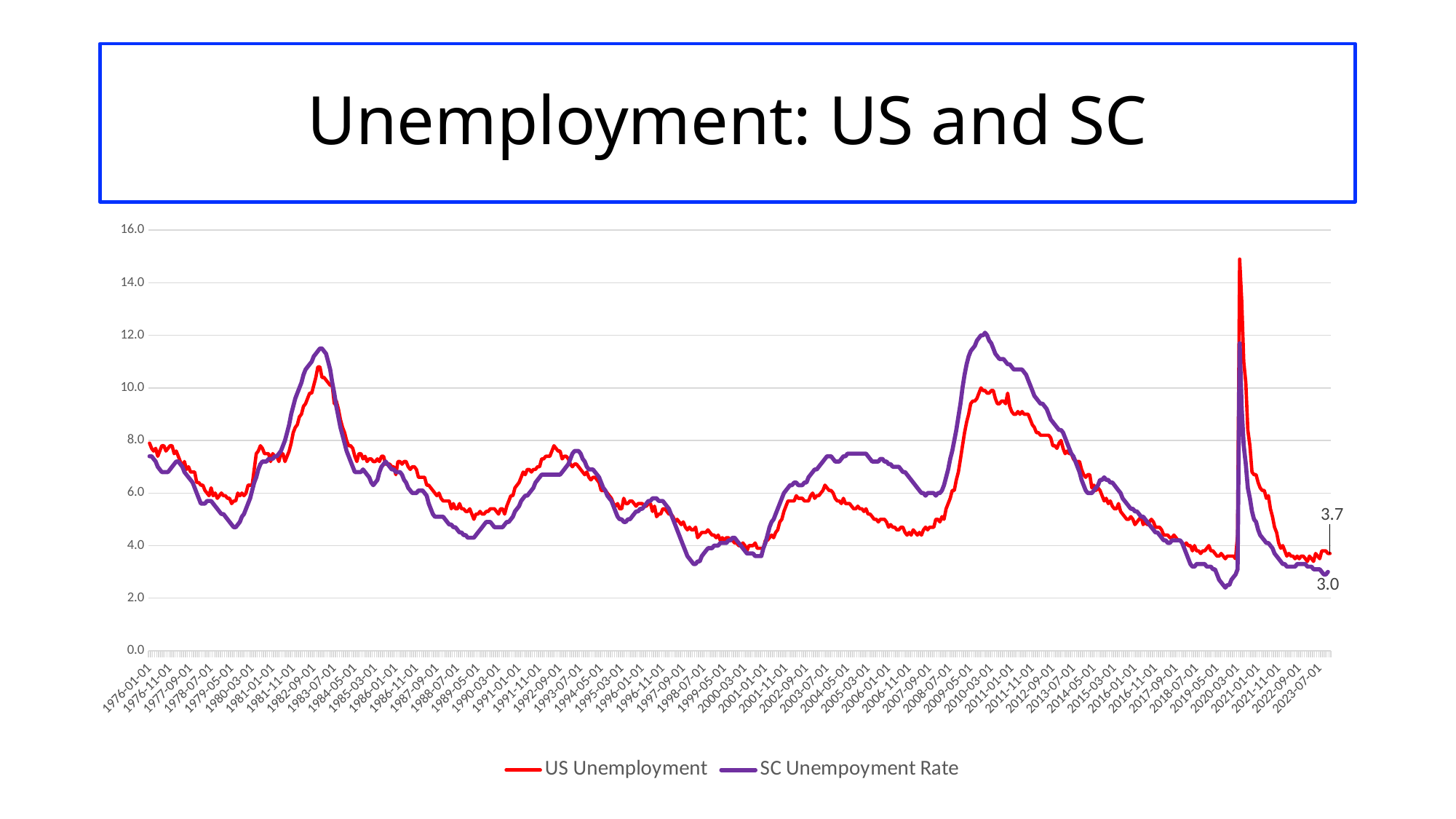
Which series reaches the highest value anywhere on the chart? US Unemployment Between 2010 and 2019, do the unemployment values generally rise or fall? fall How many series does the legend list? 2 Is the peak value of the US Unemployment series around 2020 greater or less than 14.0? greater Is the SC Unemployment Rate value around 2019-05-01 greater or less than 4.0? less What is the difference between the final labelled US Unemployment value and the final labelled SC Unemployment Rate value? 0.7 What is the final labelled value of the SC Unemployment Rate series? 3.0 What colour is the SC Unemployment Rate line? Purple At the end of the chart, which series has the higher labelled value, US Unemployment or SC Unemployment Rate? US Unemployment What kind of chart is shown on the slide? Line chart Is the peak value of the SC Unemployment Rate series around 2010 greater or less than 11.0? greater What is the final labelled value of the US Unemployment series? 3.7